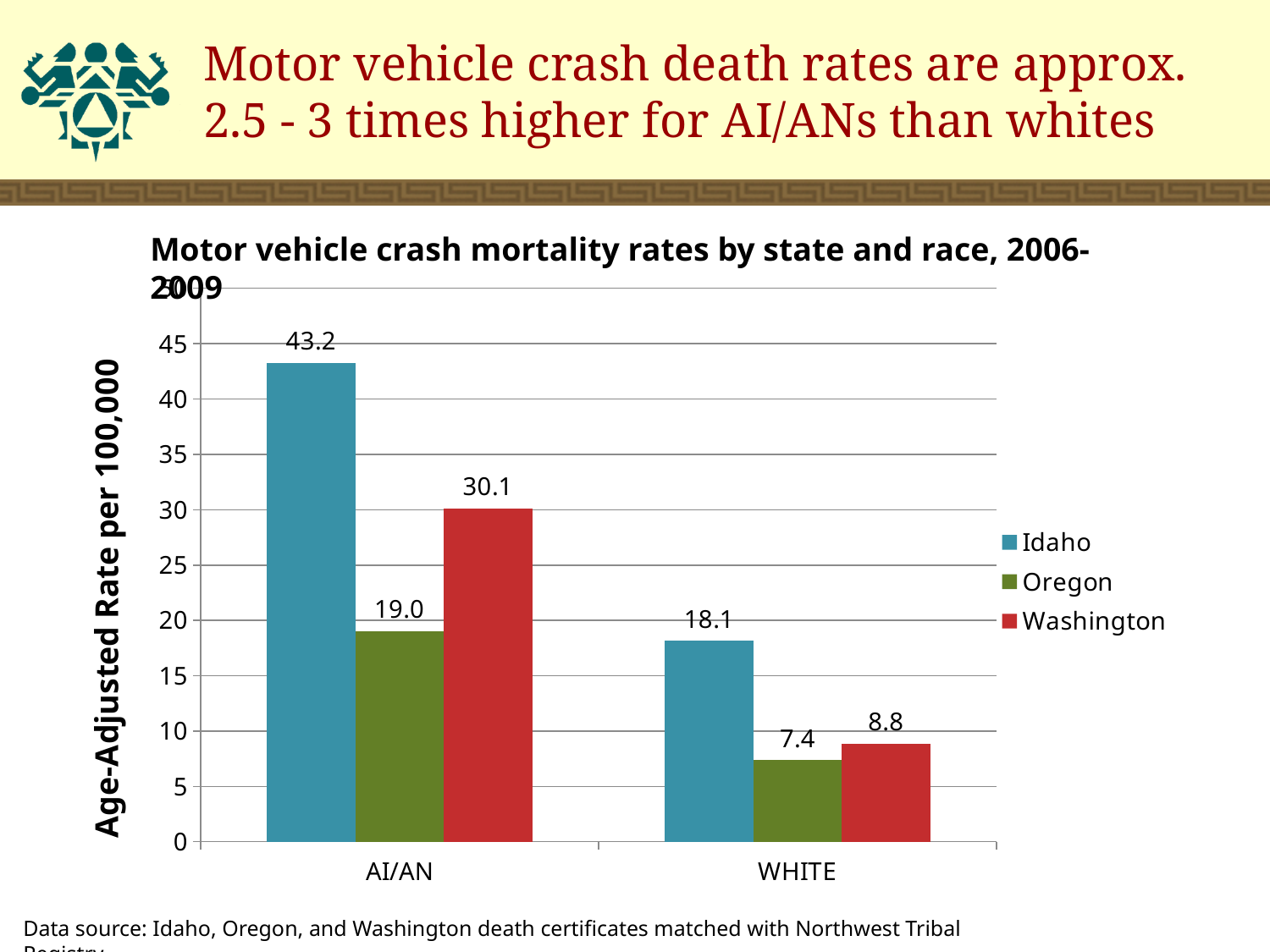
What is the difference between the Idaho rates for AI/AN and WHITE? 25.1 What is the age-adjusted motor vehicle crash mortality rate for AI/AN in Idaho? 43.2 How many series does the legend list? 3 What is the age-adjusted motor vehicle crash mortality rate for WHITE in Oregon? 7.4 What is the rate for AI/AN in Washington? 30.1 What is the label of the y axis? Age-Adjusted Rate per 100,000 Which is larger, the Washington rate for AI/AN or the Idaho rate for WHITE? Washington rate for AI/AN How many race categories are shown on the x axis? 2 Which state has the lowest rate for WHITE? Oregon Which state has the highest rate for AI/AN? Idaho What kind of chart is shown on the slide? Bar chart Is the Oregon rate for AI/AN greater or less than 15? greater